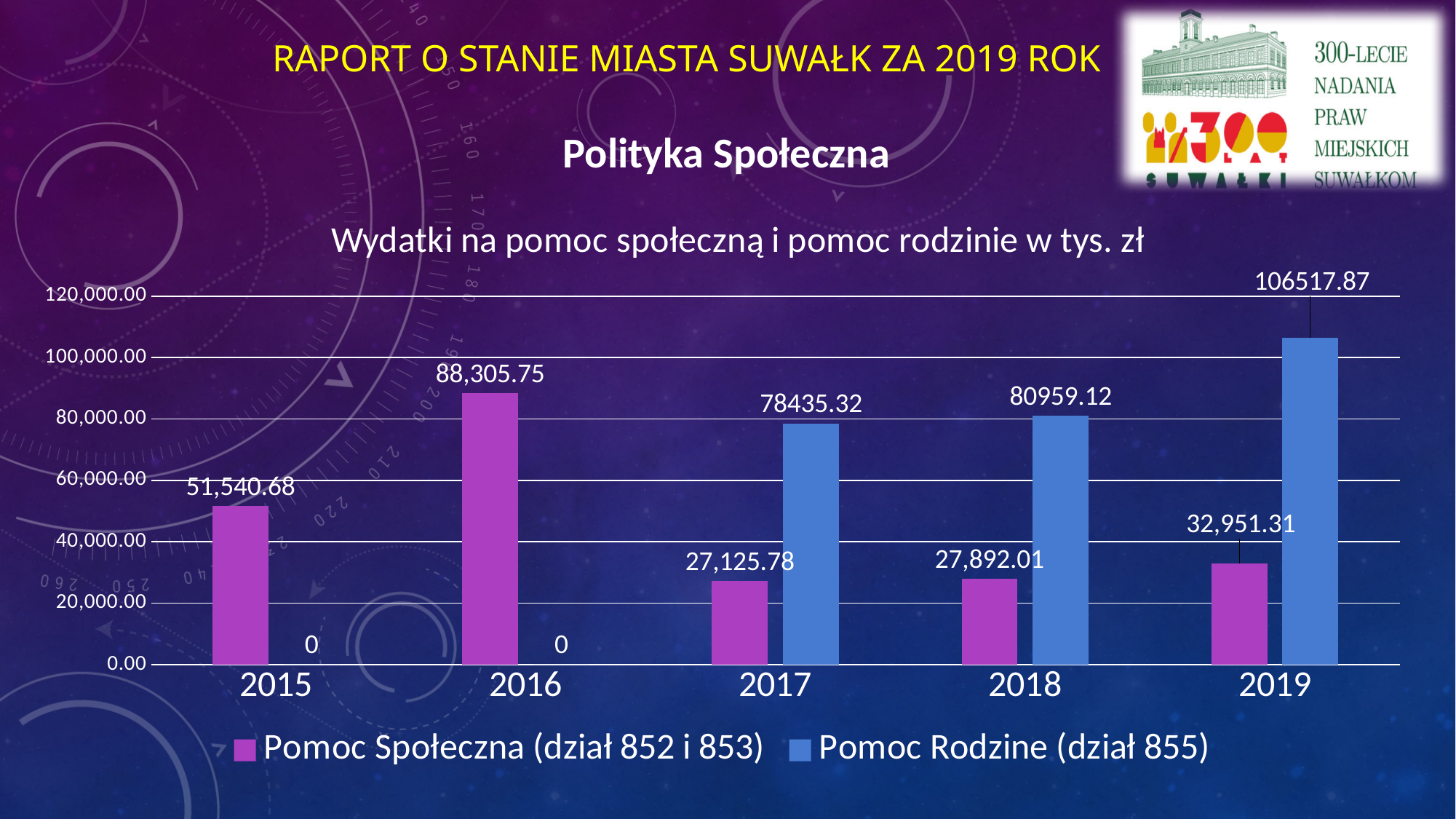
What is the value for Pomoc Społeczna (dział 852 i 853) in 2018? 27,892.01 What is the value for Pomoc Rodzine (dział 855) in 2015? 0 What is the value for Pomoc Rodzine (dział 855) in 2019? 106517.87 In which year is the value for Pomoc Społeczna (dział 852 i 853) lowest? 2017 How many years are shown on the x axis? 5 How many series does the legend list? 2 In which year is the value for Pomoc Społeczna (dział 852 i 853) highest? 2016 What is the difference between the Pomoc Rodzine (dział 855) values for 2019 and 2018? 25558.75 What kind of chart is shown on the slide? bar chart What is the value for Pomoc Społeczna (dział 852 i 853) in 2016? 88,305.75 Which is larger in 2019: Pomoc Społeczna (dział 852 i 853) or Pomoc Rodzine (dział 855)? Pomoc Rodzine (dział 855) What is the value for Pomoc Rodzine (dział 855) in 2017? 78435.32